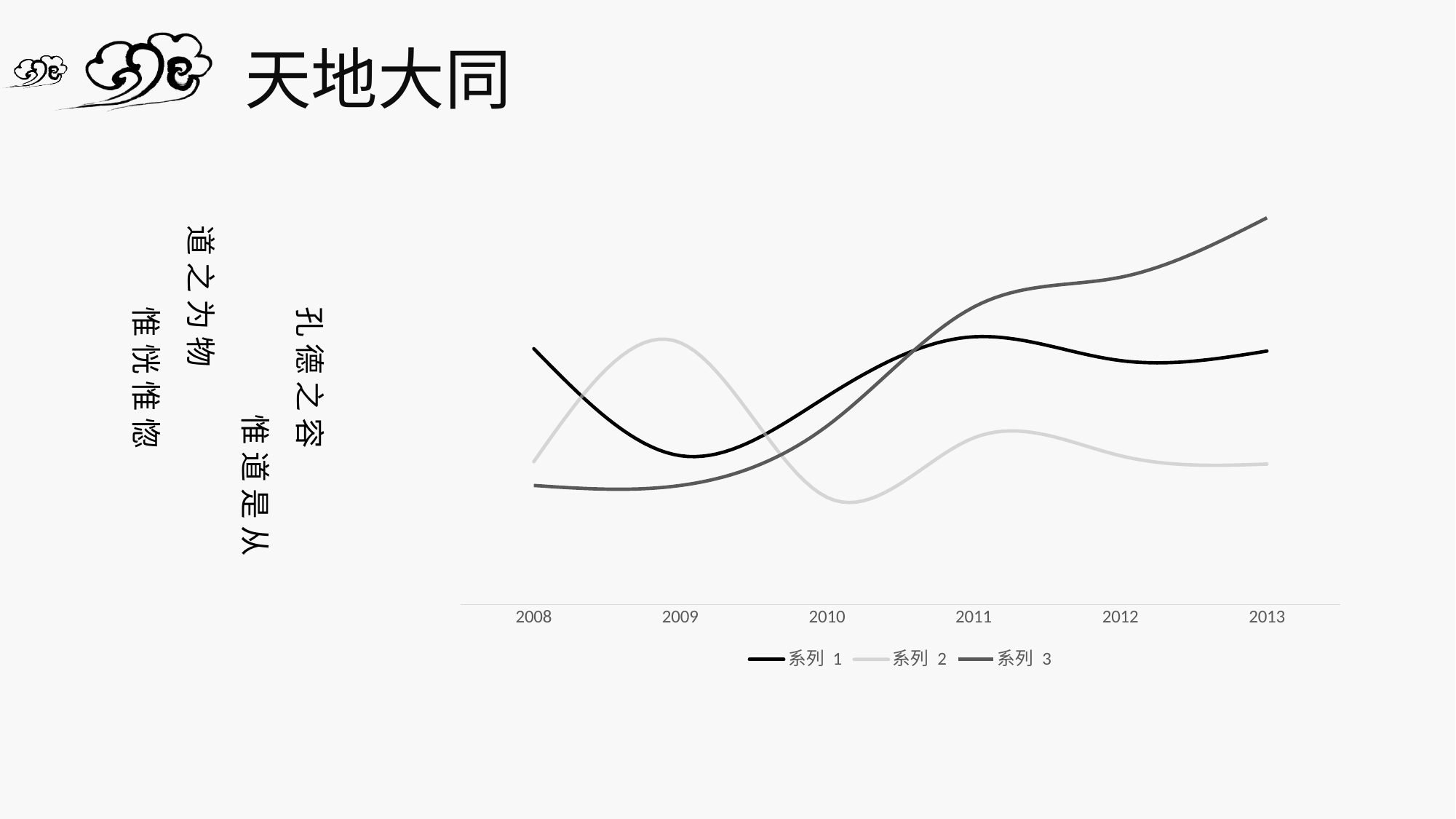
Which series has the lowest value in 2013? 系列 2 In 2012, which is larger: the value for 系列 3 or the value for 系列 2? 系列 3 Which series has the highest value in 2013? 系列 3 How many series does the chart legend list? 3 How many years are shown along the x axis of the chart? 6 Does the value for 系列 3 rise or fall from 2008 to 2013? rise Which series has the lowest value in 2008? 系列 3 What is the last year shown on the x axis? 2013 What kind of chart is shown on the slide? line chart What is the first year shown on the x axis? 2008 In 2008, which is larger: the value for 系列 1 or the value for 系列 3? 系列 1 Which series has the highest value in 2009? 系列 2